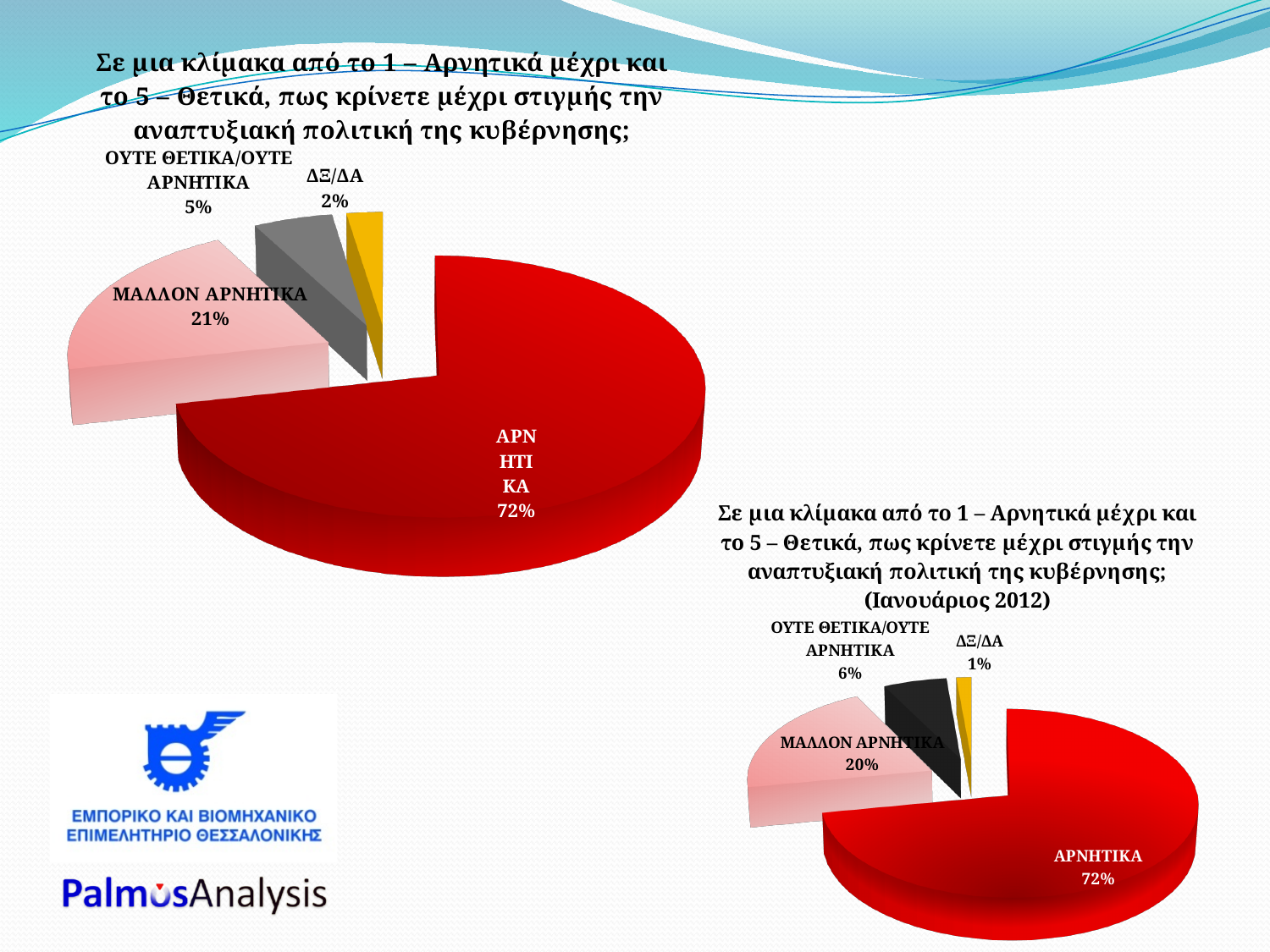
In the top-left pie chart, what colour is the ΑΡΝΗΤΙΚΑ slice? Red In the top-left pie chart, what percentage is shown for ΑΡΝΗΤΙΚΑ? 72% In the bottom-right pie chart (Ιανουάριος 2012), which is larger: ΟΥΤΕ ΘΕΤΙΚΑ/ΟΥΤΕ ΑΡΝΗΤΙΚΑ or ΔΞ/ΔΑ? ΟΥΤΕ ΘΕΤΙΚΑ/ΟΥΤΕ ΑΡΝΗΤΙΚΑ How many slices does the top-left pie chart have? 4 In the bottom-right pie chart (Ιανουάριος 2012), which category has the largest share? ΑΡΝΗΤΙΚΑ What type of chart is the bottom-right chart (Ιανουάριος 2012)? Pie chart In the top-left pie chart, which category has the smallest share? ΔΞ/ΔΑ In the bottom-right pie chart (Ιανουάριος 2012), what percentage is shown for ΜΑΛΛΟΝ ΑΡΝΗΤΙΚΑ? 20% In the top-left pie chart, what percentage is shown for ΔΞ/ΔΑ? 2% In the top-left pie chart, what percentage is shown for ΜΑΛΛΟΝ ΑΡΝΗΤΙΚΑ? 21% In the top-left pie chart, what is the difference in percentage points between ΑΡΝΗΤΙΚΑ and ΜΑΛΛΟΝ ΑΡΝΗΤΙΚΑ? 51 In the bottom-right pie chart (Ιανουάριος 2012), what percentage is shown for ΟΥΤΕ ΘΕΤΙΚΑ/ΟΥΤΕ ΑΡΝΗΤΙΚΑ? 6%